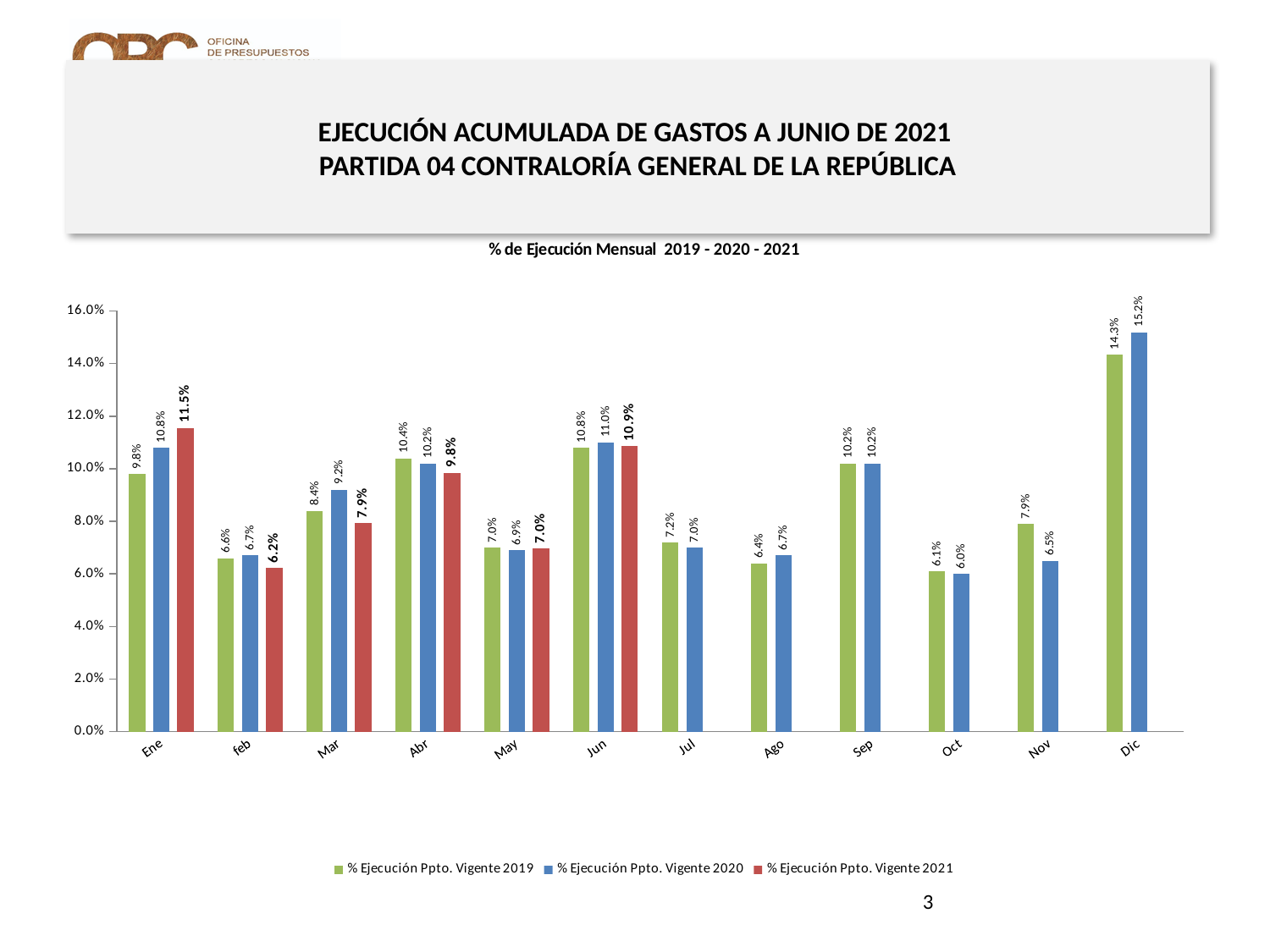
How many series does the legend list? 3 What is the value for % Ejecución Ppto. Vigente 2020 in Dic? 15.2% Is the value for % Ejecución Ppto. Vigente 2020 in Jun greater or less than 10.0%? greater What is the value for % Ejecución Ppto. Vigente 2021 in Ene? 11.5% In Nov, which series is larger: % Ejecución Ppto. Vigente 2019 or % Ejecución Ppto. Vigente 2020? % Ejecución Ppto. Vigente 2019 What is the title of the chart? % de Ejecución Mensual 2019 - 2020 - 2021 What is the difference between the 2020 and 2019 values in Dic? 0.9% Which month has the lowest value for % Ejecución Ppto. Vigente 2021? feb What kind of chart is shown on the slide? Bar chart Which month has the highest value for % Ejecución Ppto. Vigente 2019? Dic How many months are shown on the x axis? 12 What is the value for % Ejecución Ppto. Vigente 2019 in Abr? 10.4%